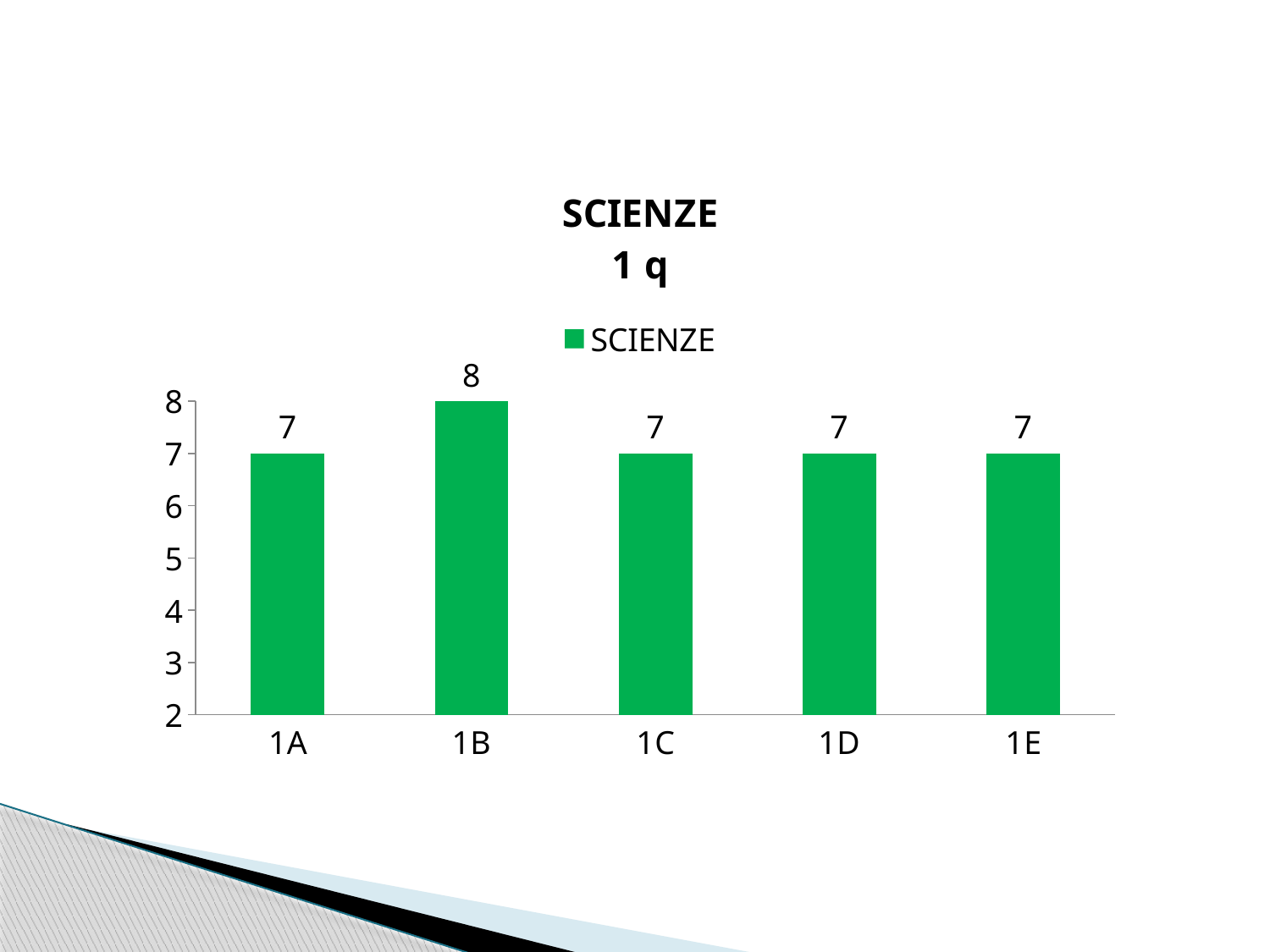
How many series does the legend list? 1 Which is larger, the value for 1B or the value for 1E? 1B What is the difference between the values for 1B and 1C? 1 How many categories are shown on the x axis? 5 What kind of chart is shown? bar chart What is the value for 1B? 8 What is the value for 1A? 7 What is the value for 1D? 7 What colour are the bars? green What is the title of the chart? SCIENZE 1 q Which category has the highest value? 1B Is the value for 1B greater or less than 7? greater